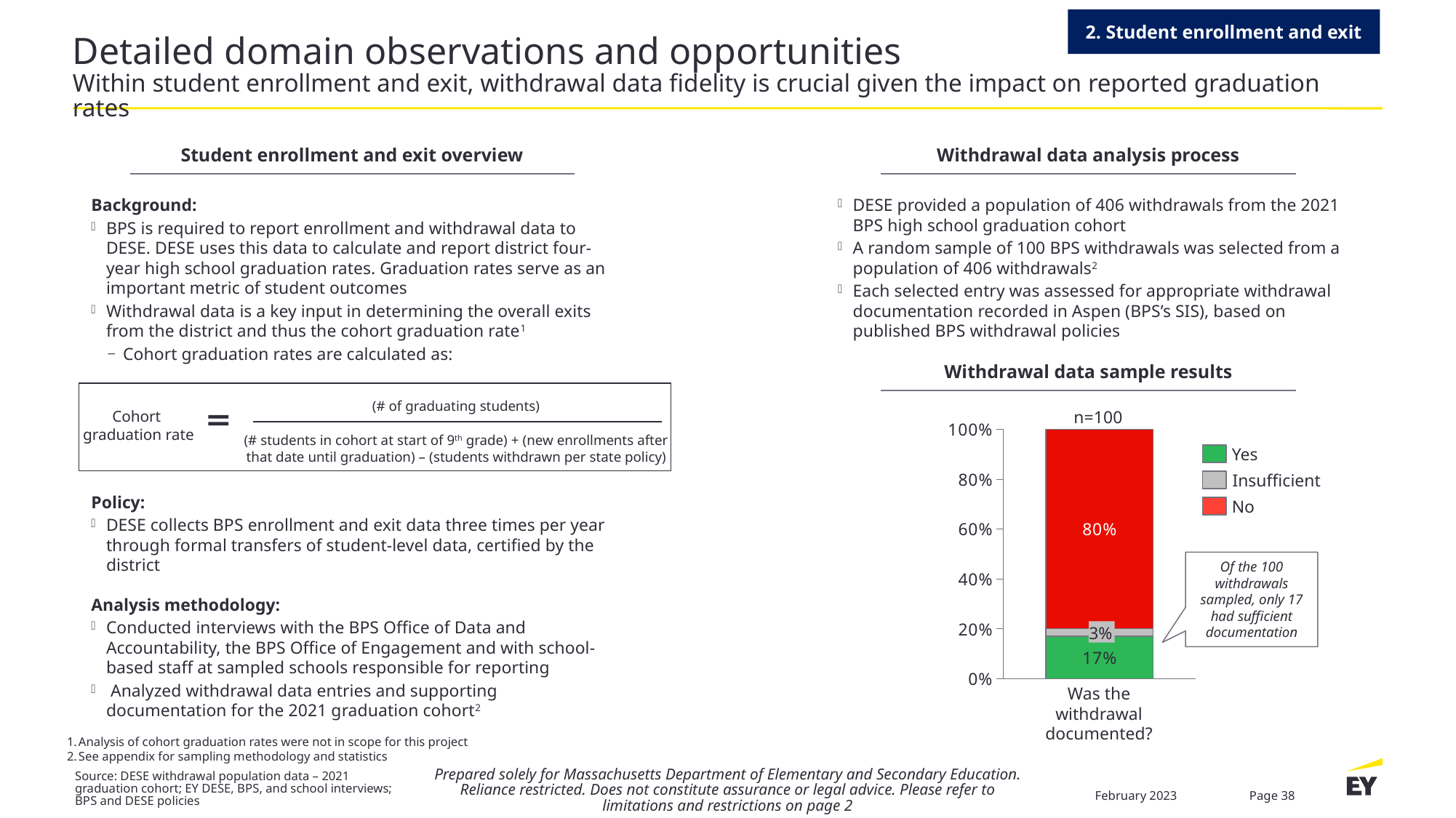
What sample size (n) is shown above the bar in the Withdrawal data sample results chart? n=100 What percentage of sampled withdrawals fall in the 'No' segment of the Withdrawal data sample results chart? 80% What type of chart is the Withdrawal data sample results chart? Stacked bar chart What is the total of the stacked bar in the Withdrawal data sample results chart? 100% Is the 'No' segment in the Withdrawal data sample results chart greater or less than 60%? greater Which segment of the stacked bar in the Withdrawal data sample results chart is the smallest? Insufficient How many series does the legend of the Withdrawal data sample results chart list? 3 Which segment of the stacked bar in the Withdrawal data sample results chart is the largest? No What is the difference in percentage points between the 'No' and 'Yes' segments in the Withdrawal data sample results chart? 63 percentage points What percentage of sampled withdrawals had 'Insufficient' documentation according to the chart? 3% What percentage of sampled withdrawals had a 'Yes' for documentation in the Withdrawal data sample results chart? 17% In the Withdrawal data sample results chart, which is larger: the 'Yes' segment or the 'Insufficient' segment? Yes